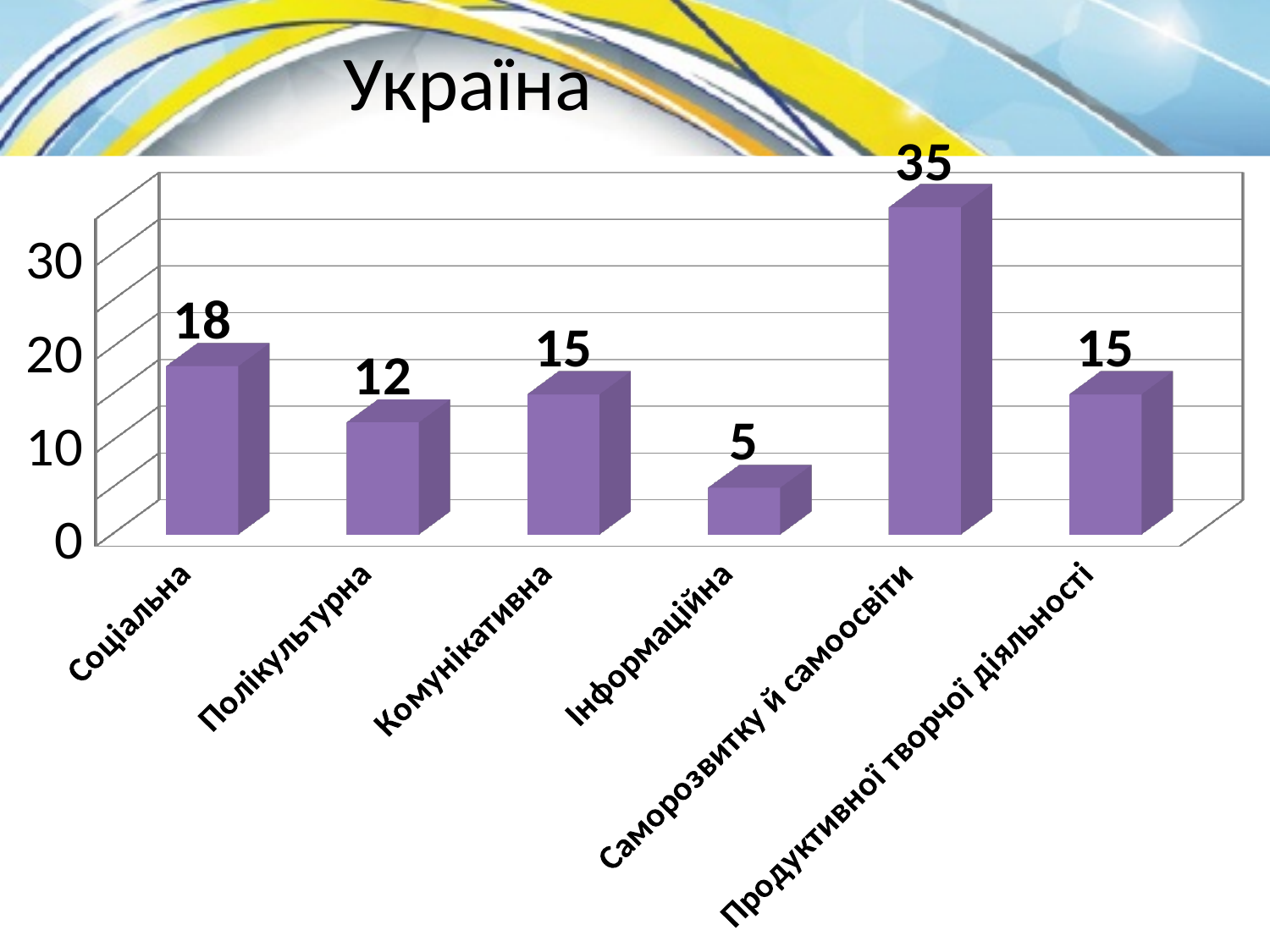
What is the value for Соціальна? 18 Which category has the lowest value? Інформаційна What is the value for Саморозвитку й самоосвіти? 35 What is the difference between the values for Саморозвитку й самоосвіти and Соціальна? 17 How many categories are shown on the chart? 6 Which is larger, the value for Соціальна or the value for Полікультурна? Соціальна What is the value for Інформаційна? 5 What kind of chart is shown on the slide? bar chart Is the value for Саморозвитку й самоосвіти greater or less than 30? greater Which category has the highest value? Саморозвитку й самоосвіти What is the title of the slide? Україна What is the value for Полікультурна? 12